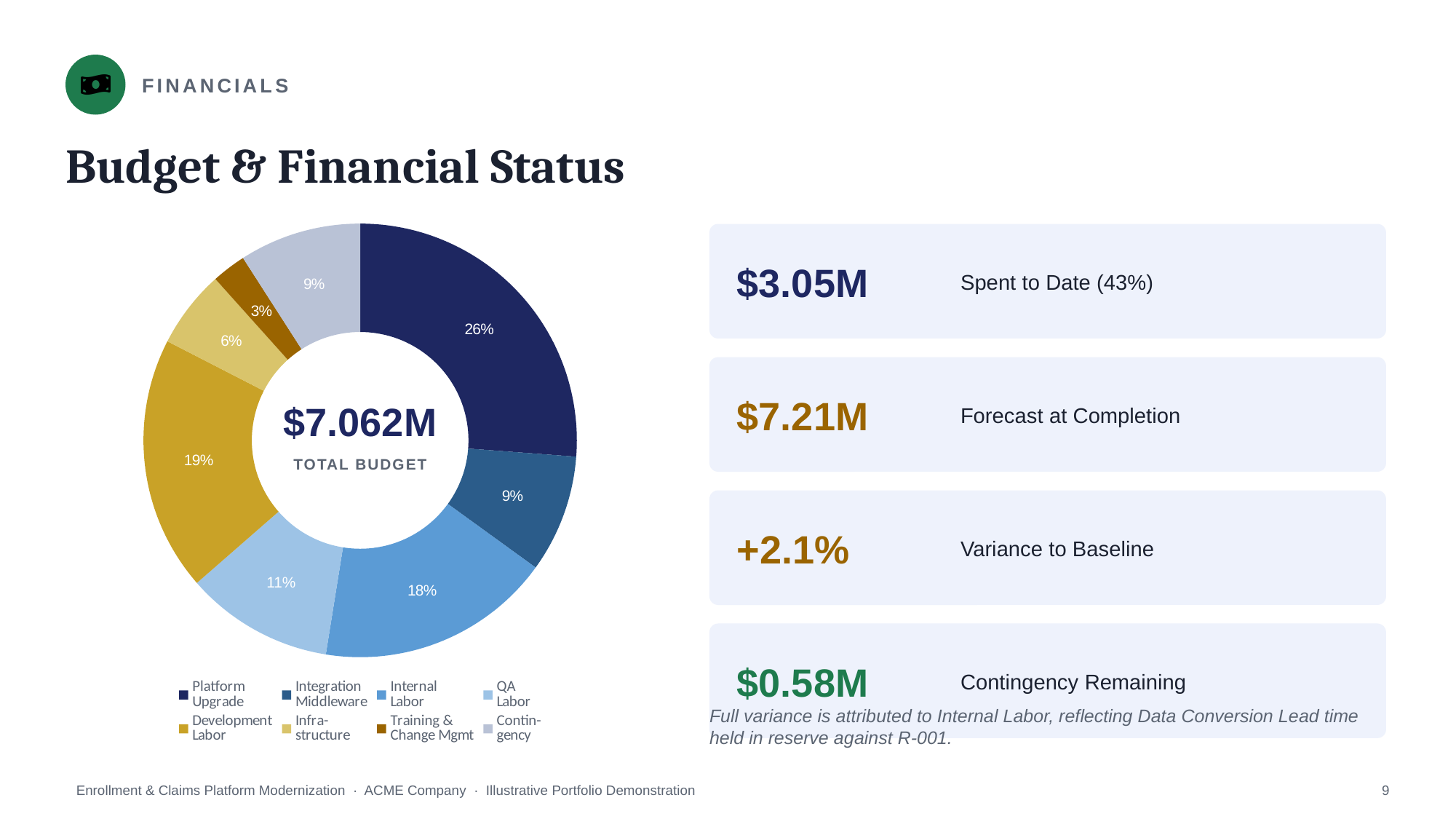
Which category has the largest share of the budget? Platform Upgrade What is the difference in percentage points between Platform Upgrade and QA Labor? 15 percentage points What share of the budget is Infrastructure? 6% Which is larger, the share for Development Labor or the share for Internal Labor? Development Labor What share of the total budget is Platform Upgrade? 26% How many categories does the donut chart show? 8 What share of the total budget is Internal Labor? 18% What total budget is shown in the centre of the donut chart? $7.062M What kind of chart is shown on the slide? Donut (pie) chart Which category has the smallest share of the budget? Training & Change Mgmt